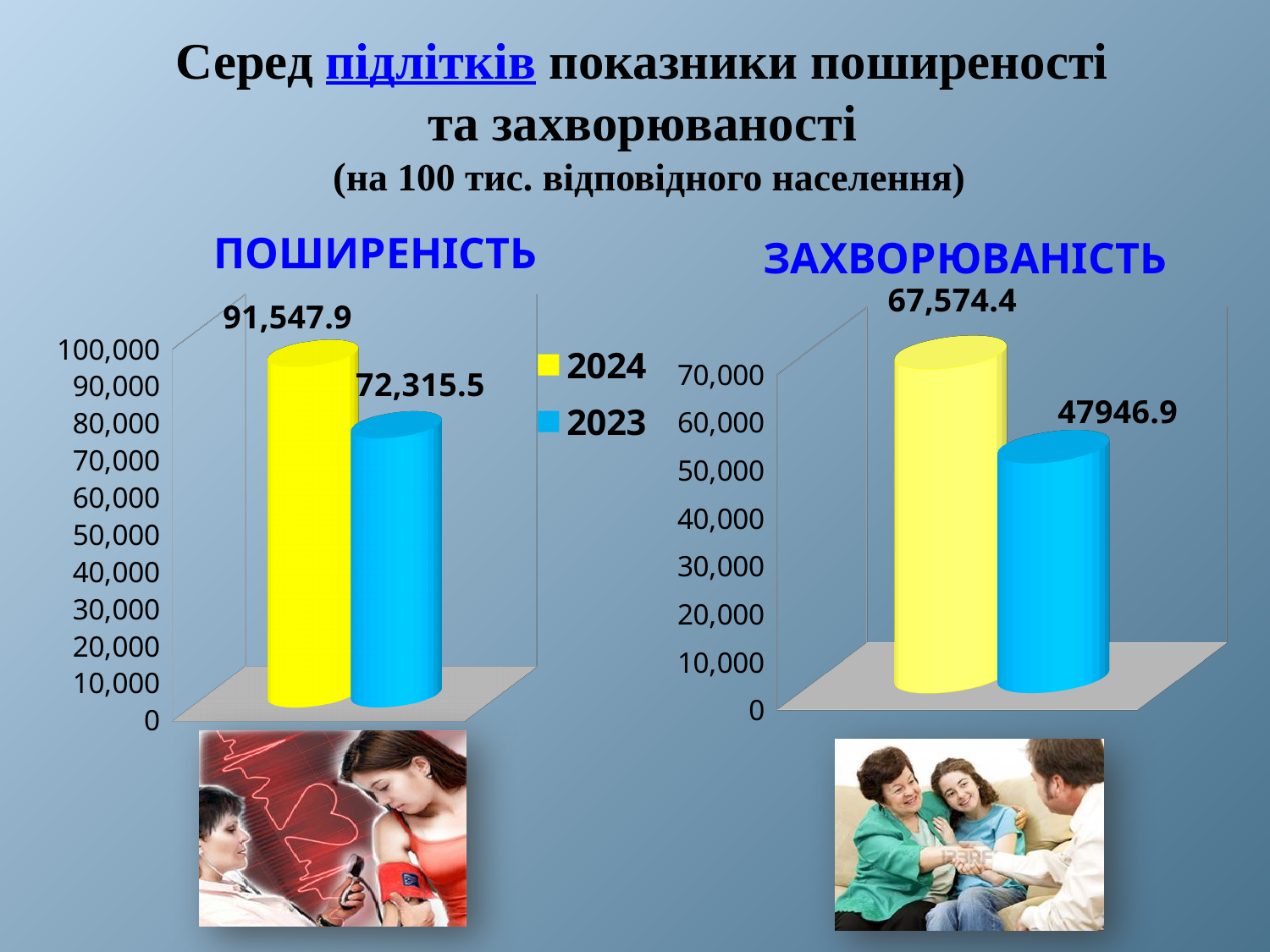
In the ПОШИРЕНІСТЬ chart, what is the difference between the 2024 and 2023 values? 19,232.4 In the ЗАХВОРЮВАНІСТЬ chart, which year has the lower value? 2023 In the ПОШИРЕНІСТЬ chart, what is the value for 2023? 72,315.5 What kind of chart is the ПОШИРЕНІСТЬ chart? bar chart How many series does the legend list? 2 In the ПОШИРЕНІСТЬ chart, which year has the higher value? 2024 In the ЗАХВОРЮВАНІСТЬ chart, what is the difference between the 2024 and 2023 values? 19,627.5 In the ЗАХВОРЮВАНІСТЬ chart, what is the value for 2023? 47946.9 In the ПОШИРЕНІСТЬ chart, what is the value for 2024? 91,547.9 Which colour represents 2023 in the charts? blue Is the 2024 value in the ЗАХВОРЮВАНІСТЬ chart greater or less than the 2023 value in the ПОШИРЕНІСТЬ chart? less In the ЗАХВОРЮВАНІСТЬ chart, what is the value for 2024? 67,574.4